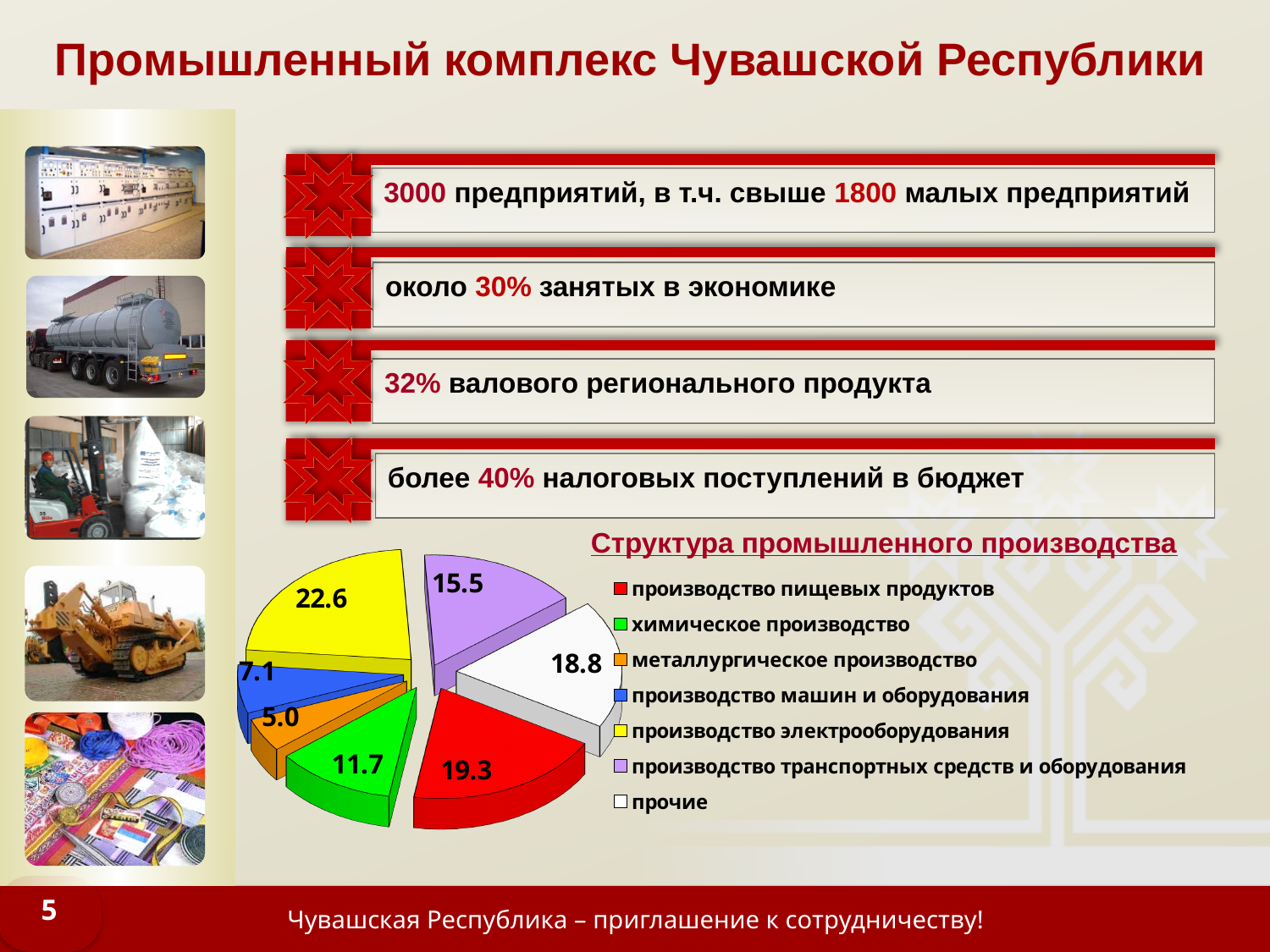
Как называется диаграмма на слайде? Структура промышленного производства Какая доля приходится на производство пищевых продуктов в структуре промышленного производства? 19.3 Какое значение указано для категории «прочие» на диаграмме? 18.8 Что больше: доля производства пищевых продуктов или доля химического производства? производство пищевых продуктов Каким цветом на диаграмме обозначено металлургическое производство? оранжевым Какое значение указано для производства транспортных средств и оборудования? 15.5 На сколько доля производства электрооборудования больше доли производства машин и оборудования? 15.5 Сколько категорий показано на круговой диаграмме «Структура промышленного производства»? 7 Какая категория имеет наибольшую долю в структуре промышленного производства? производство электрооборудования Какого типа диаграмма «Структура промышленного производства»? круговая диаграмма Какое значение указано для химического производства на круговой диаграмме? 11.7 Какая категория имеет наименьшую долю в структуре промышленного производства? металлургическое производство